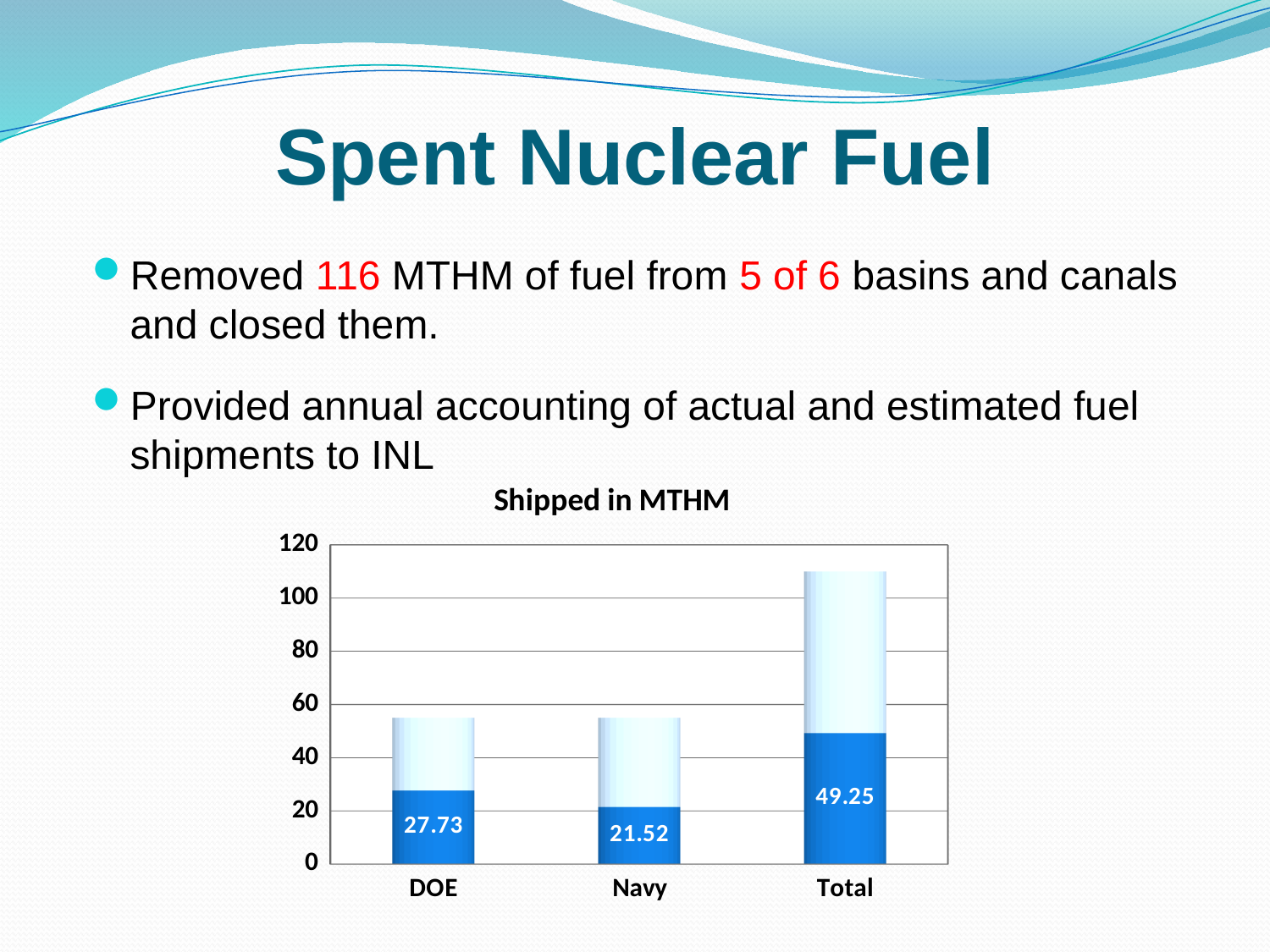
Which category has the highest labelled dark blue value? Total Is the full height of the Total bar greater or less than 100? greater How many categories are shown on the x axis? 3 What is the difference between the labelled dark blue values for DOE and Navy? 6.21 Which category has the lowest labelled dark blue value? Navy What is the value printed on the dark blue segment of the Total bar? 49.25 Which has the larger labelled dark blue value, DOE or Navy? DOE Is the full height of the DOE bar greater or less than 60? less What kind of chart is shown on the slide? Bar chart What is the title of the chart? Shipped in MTHM What is the value printed on the dark blue segment of the Navy bar? 21.52 What is the value printed on the dark blue segment of the DOE bar? 27.73